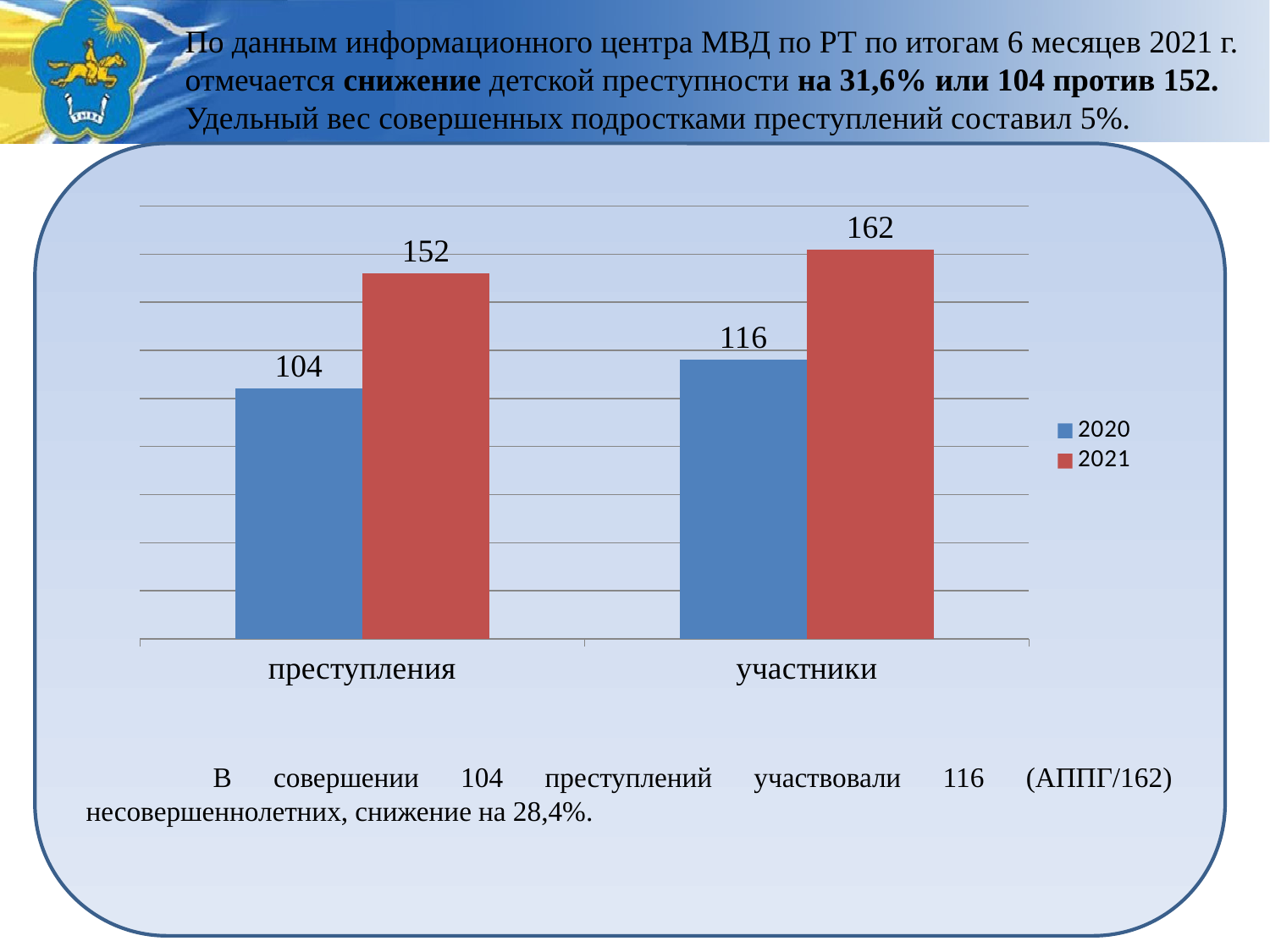
What is the value of the 2021 series for участники? 162 What is the value of the 2021 series for преступления? 152 What is the difference between the 2021 and 2020 values for преступления? 48 How many series does the legend list? 2 Which is larger for участники: the 2020 value or the 2021 value? 2021 How many categories are shown on the x axis? 2 What is the difference between the 2021 and 2020 values for участники? 46 What is the value of the 2020 series for участники? 116 Which category has the highest value in the 2021 series? участники Which category has the lowest value in the 2020 series? преступления What is the value of the 2020 series for преступления? 104 What kind of chart is shown on the slide? bar chart